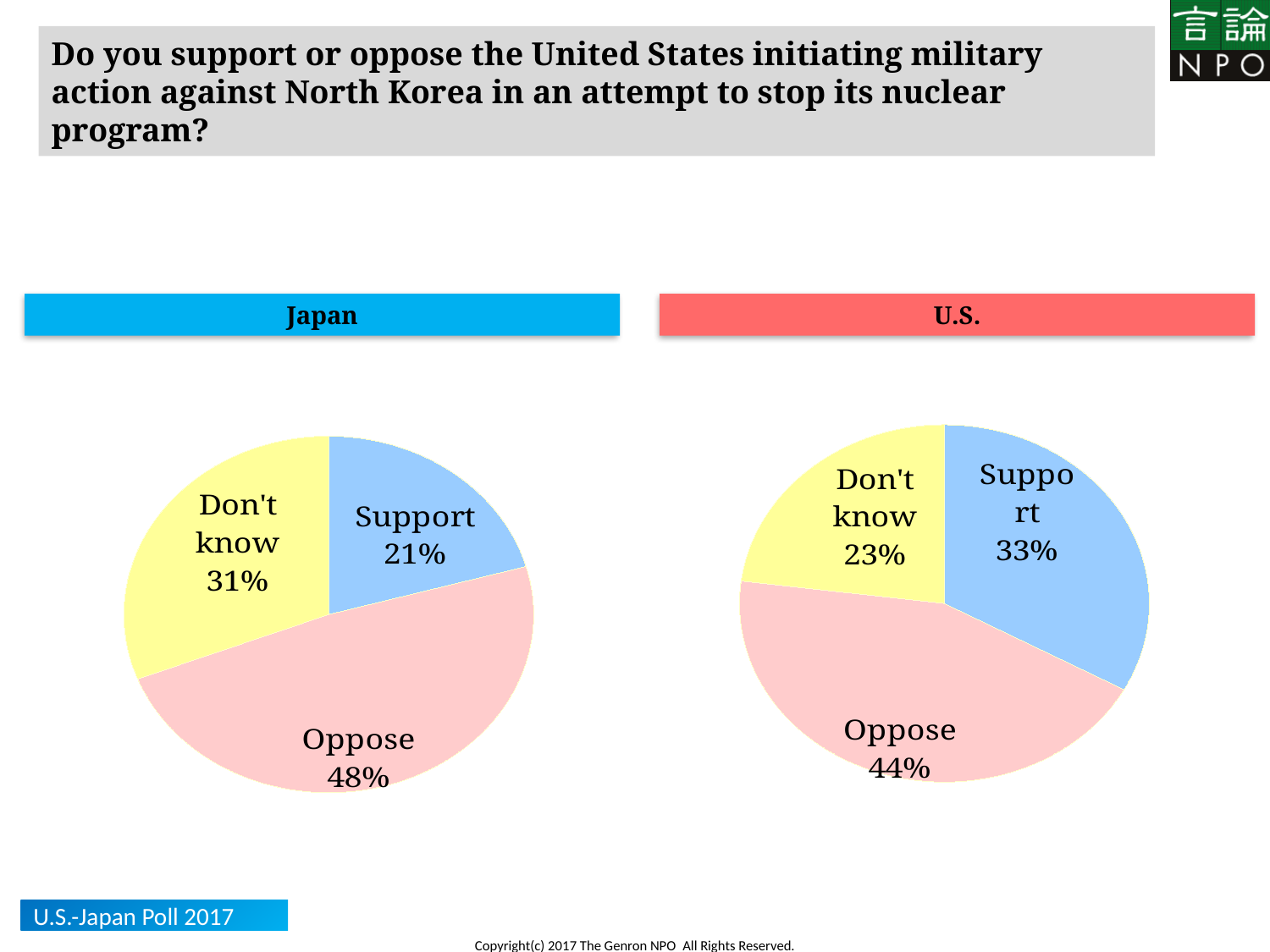
What is the difference between the Oppose share in the Japan chart and the Oppose share in the U.S. chart? 4 percentage points In the U.S. pie chart, which response has the smallest share? Don't know In the Japan pie chart, what percentage of respondents answered Oppose? 48% In the Japan pie chart, which response has the smallest share? Support In the Japan pie chart, what percentage answered Don't know? 31% In the U.S. pie chart, what percentage answered Oppose? 44% In the U.S. pie chart, what percentage of respondents answered Support? 33% What type of chart is used to show the U.S. results? Pie chart How many slices does the Japan pie chart have? 3 In the U.S. pie chart, what colour is the Oppose slice? Pink Which is larger: the Support share in the Japan chart or the Support share in the U.S. chart? U.S. In the Japan pie chart, which response has the largest share? Oppose